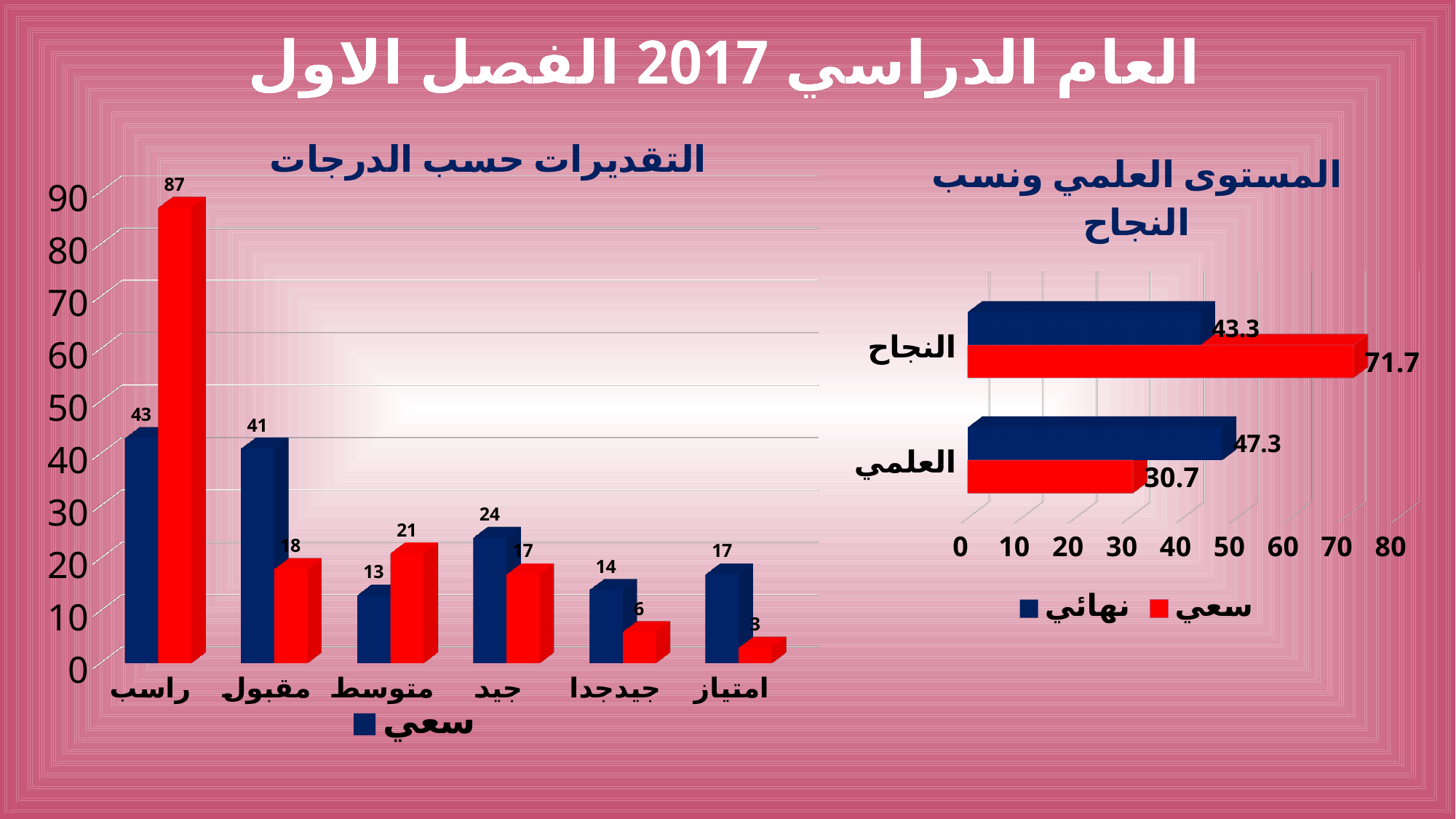
In the chart titled "التقديرات حسب الدرجات", how many categories are shown on the x axis? 6 In the chart titled "التقديرات حسب الدرجات", which category has the lowest blue (سعي) bar? متوسط In the chart titled "المستوى العلمي ونسب النجاح", what is the value of نهائي for العلمي? 47.3 In the chart titled "التقديرات حسب الدرجات", what is the value of the blue (سعي) bar for مقبول? 41 In the chart titled "المستوى العلمي ونسب النجاح", how many series does the legend list? 2 In the chart titled "التقديرات حسب الدرجات", which category has the highest red bar? راسب In the chart titled "التقديرات حسب الدرجات", what is the difference between the red bar and the blue bar for راسب? 44 What type of chart is the one titled "المستوى العلمي ونسب النجاح"? bar chart In the chart titled "المستوى العلمي ونسب النجاح", which is larger for العلمي: نهائي or سعي? نهائي In the chart titled "التقديرات حسب الدرجات", what is the value of the red bar for راسب? 87 In the chart titled "التقديرات حسب الدرجات", is the blue bar for جيد greater or less than 20? greater In the chart titled "المستوى العلمي ونسب النجاح", what is the value of سعي for النجاح? 71.7